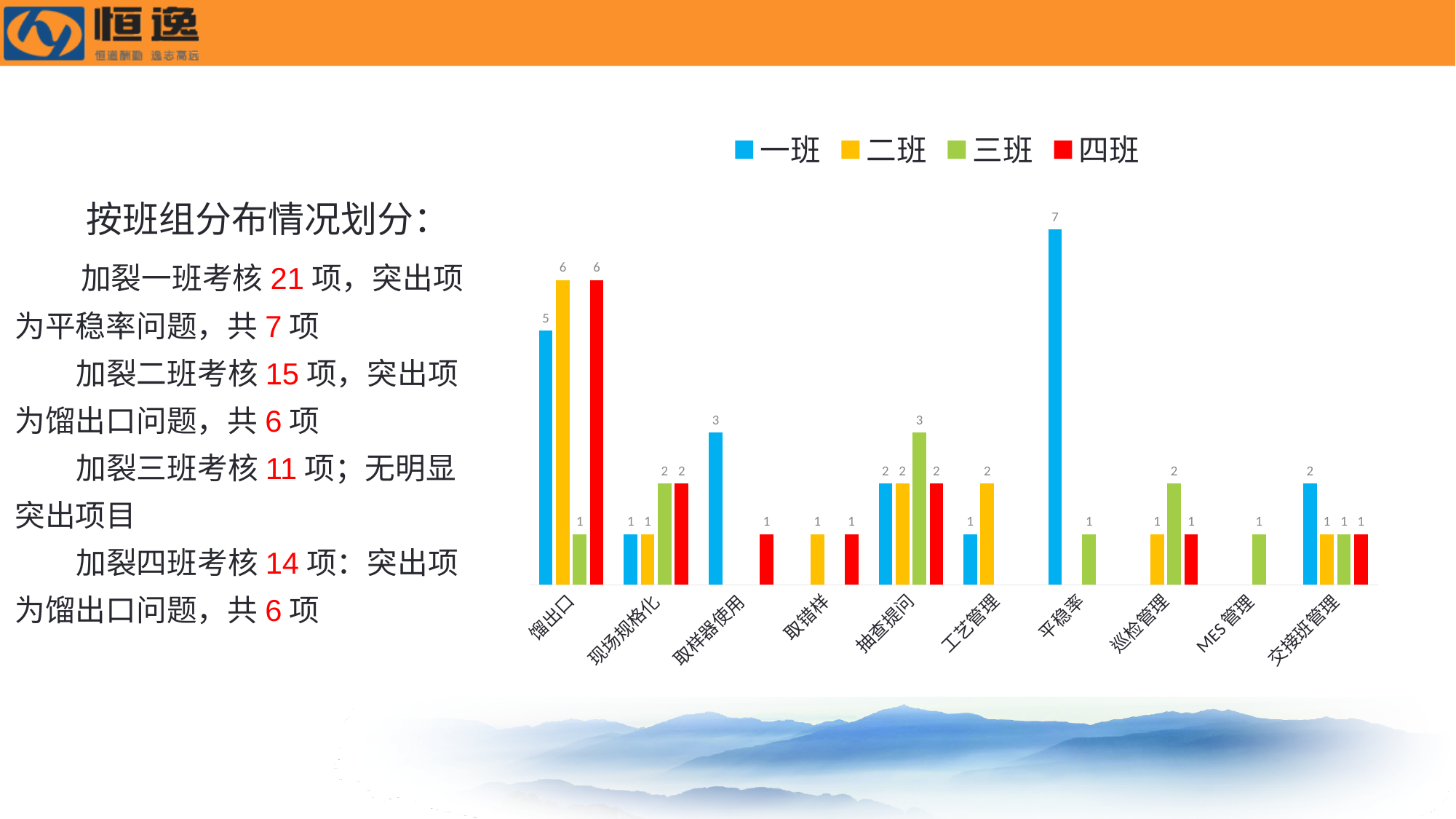
What is the value for 一班 in the 平稳率 category? 7 Which is larger in the 工艺管理 category, the value for 一班 or for 二班? 二班 How many categories are shown on the x axis of the chart? 10 What is the difference between the 二班 and 一班 values in the 馏出口 category? 1 What is the value for 一班 in the 取样器使用 category? 3 What type of chart is shown on the slide? bar chart What is the value for 四班 in the 现场规格化 category? 2 What is the value for 二班 in the 馏出口 category? 6 What is the value for 三班 in the 抽查提问 category? 3 In which category does 一班 have its highest value? 平稳率 Which colour represents 四班 in the chart? red How many series does the legend list? 4